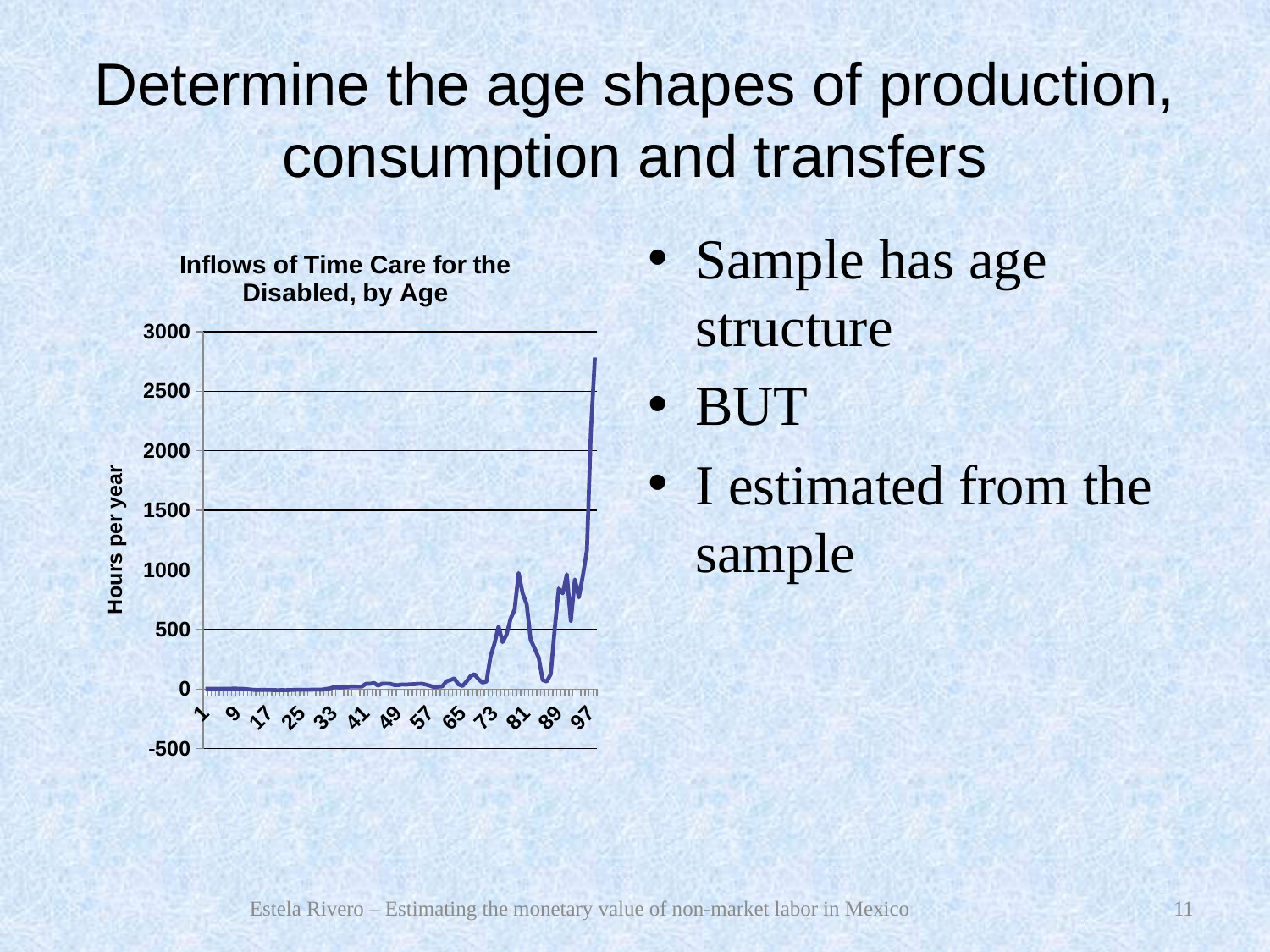
What kind of chart is shown on the slide? Line chart What is the highest tick value shown on the vertical axis? 3000 Is the value for age 49 greater or less than 500? less What is the title of the chart? Inflows of Time Care for the Disabled, by Age Is the value for age 1 greater or less than 500? less What is the label on the vertical axis of the chart? Hours per year Overall, do the values rise or fall as age increases along the x axis? Rise How many age tick labels are printed along the x axis? 13 Is the value for age 81 greater or less than 1500? less